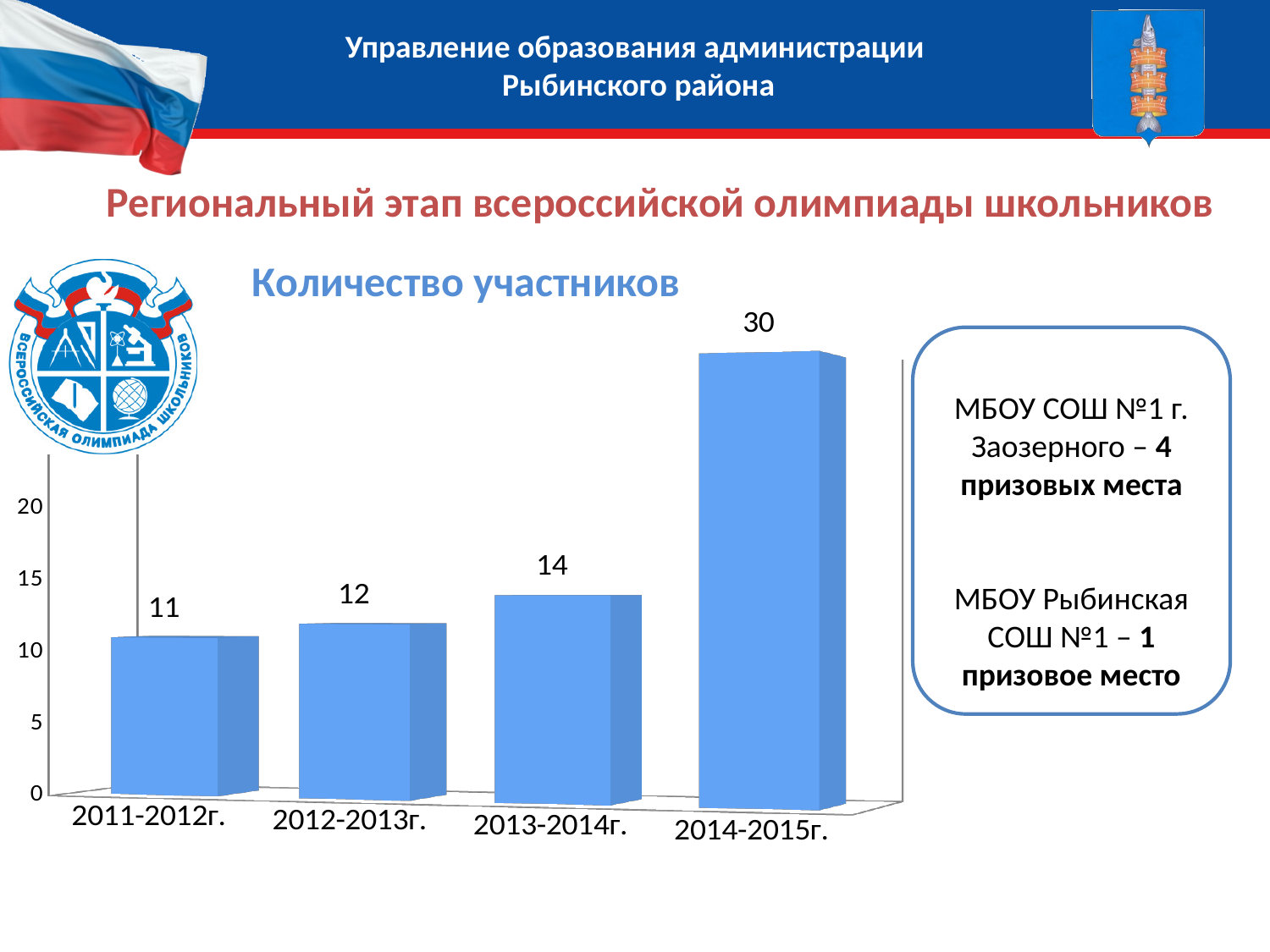
What is the number of participants for 2014-2015г.? 30 What is the number of participants for 2013-2014г.? 14 What kind of chart is shown on the slide? bar chart What is the difference in participants between 2014-2015г. and 2013-2014г.? 16 Is the value for 2014-2015г. greater or less than 20? greater What is the number of participants for 2011-2012г.? 11 What is the number of participants for 2012-2013г.? 12 How many academic years are shown in the chart? 4 Which academic year has the lowest number of participants? 2011-2012г. Do the number of participants rise or fall from 2011-2012г. to 2014-2015г.? rise Which has more participants, 2012-2013г. or 2013-2014г.? 2013-2014г. Which academic year has the highest number of participants? 2014-2015г.